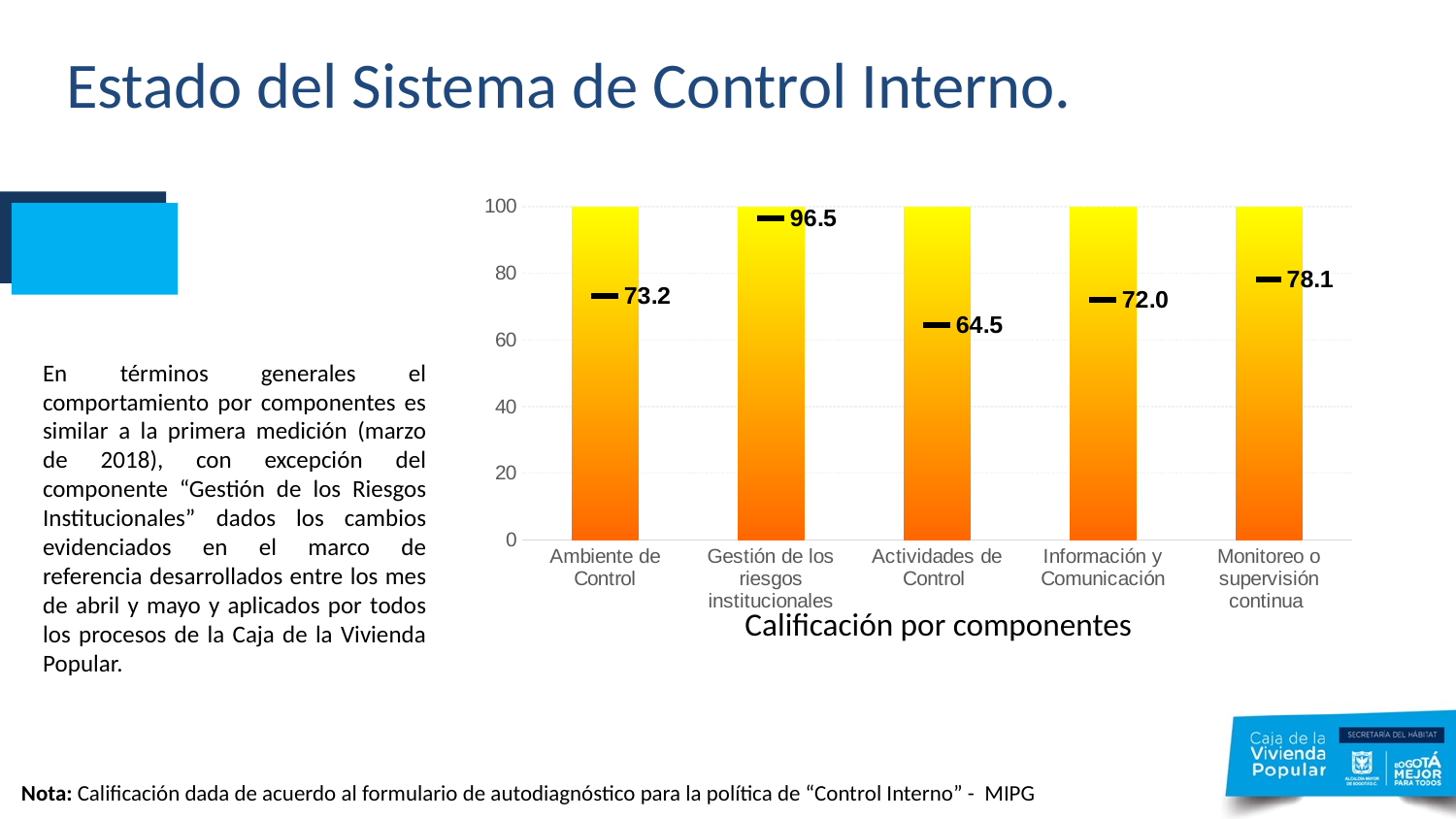
Which component has the highest value? Gestión de los riesgos institucionales What is the value for Información y Comunicación? 72.0 What is the difference between the values for Gestión de los riesgos institucionales and Actividades de Control? 32.0 What is the title of the chart? Calificación por componentes What is the value for Gestión de los riesgos institucionales? 96.5 What is the value for Monitoreo o supervisión continua? 78.1 Is the value for Monitoreo o supervisión continua greater or less than 80? less How many components are shown on the chart? 5 Which is larger, the value for Ambiente de Control or the value for Información y Comunicación? Ambiente de Control What is the value for Ambiente de Control? 73.2 Which component has the lowest value? Actividades de Control What is the value for Actividades de Control? 64.5